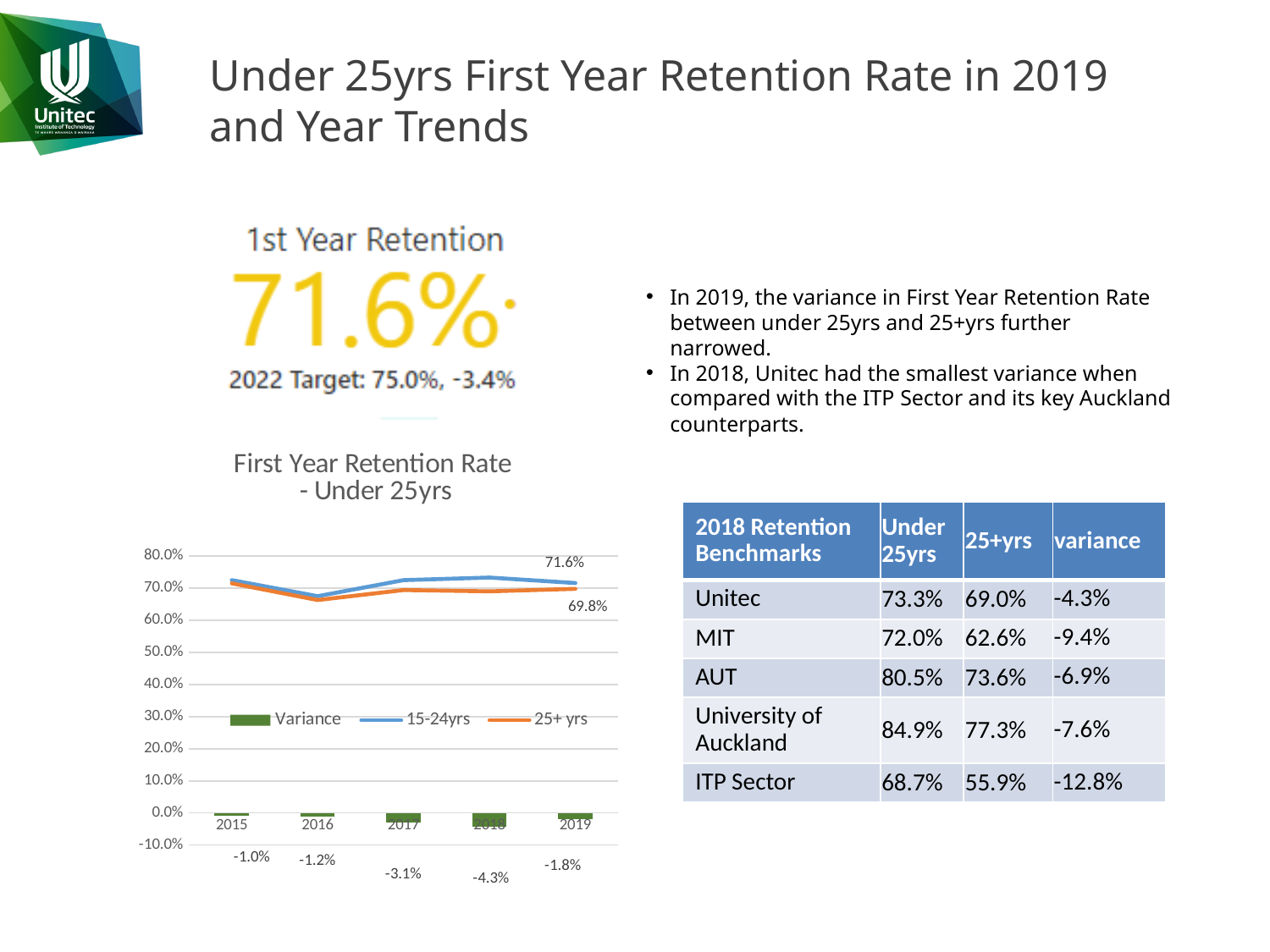
Which series in the First Year Retention Rate - Under 25yrs chart is drawn as bars rather than a line? Variance What is the Variance value for 2017 in the First Year Retention Rate - Under 25yrs chart? -3.1% What is the 15-24yrs value for 2019 in the First Year Retention Rate - Under 25yrs chart? 71.6% How many series does the legend of the First Year Retention Rate - Under 25yrs chart list? 3 In the First Year Retention Rate - Under 25yrs chart, which is higher in 2019, the 15-24yrs value or the 25+ yrs value? 15-24yrs In the First Year Retention Rate - Under 25yrs chart, what is the difference between the 15-24yrs and 25+ yrs values in 2019? 1.8% In which year is the Variance value highest in the First Year Retention Rate - Under 25yrs chart? 2015 What is the 25+ yrs value for 2019 in the First Year Retention Rate - Under 25yrs chart? 69.8% How many years are shown on the x axis of the First Year Retention Rate - Under 25yrs chart? 5 Does the Variance value in the First Year Retention Rate - Under 25yrs chart rise or fall from 2015 to 2018? fall In which year is the Variance value lowest in the First Year Retention Rate - Under 25yrs chart? 2018 In the First Year Retention Rate - Under 25yrs chart, is the 15-24yrs value for 2016 greater or less than 70.0%? less